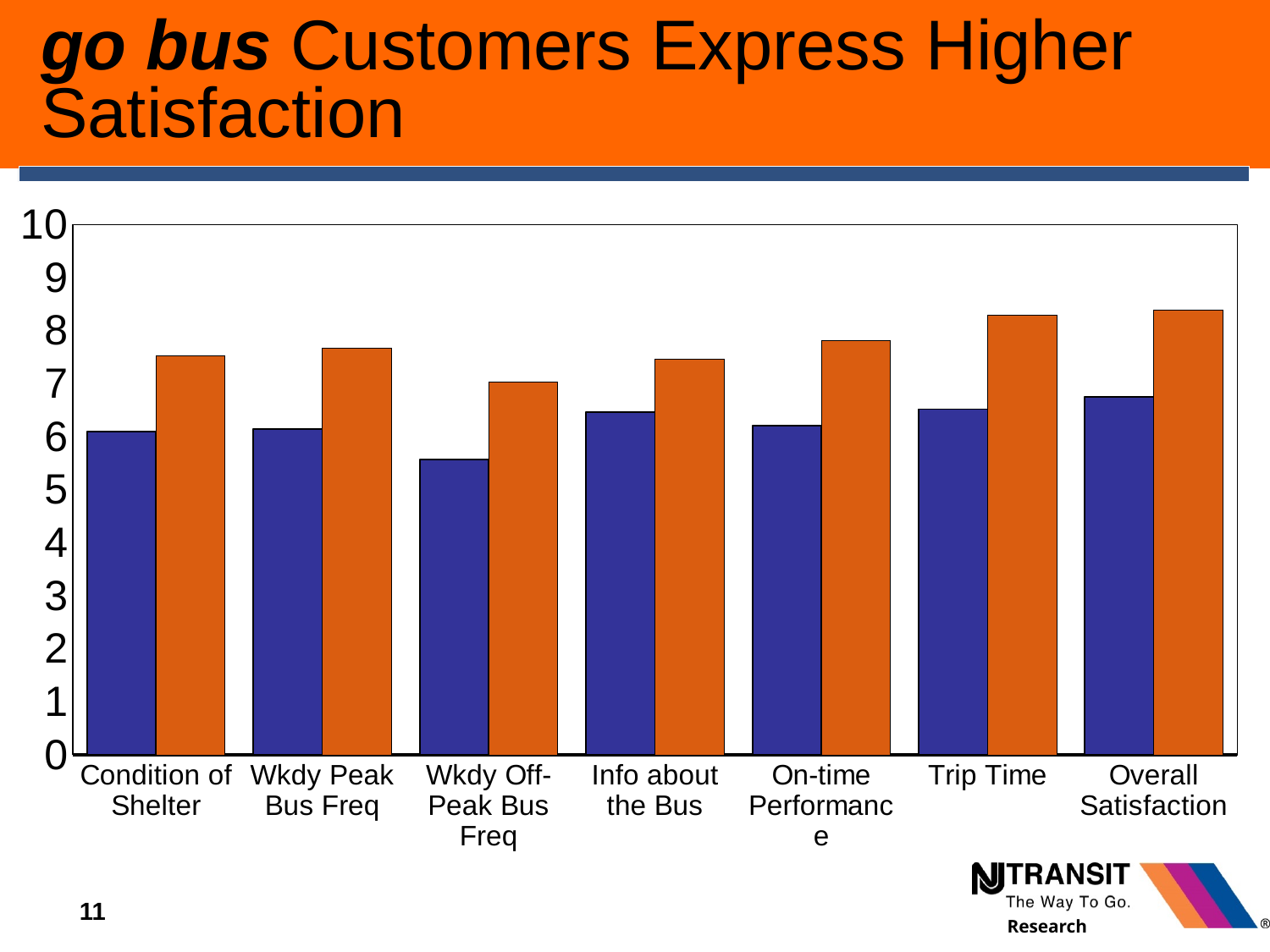
What kind of chart is shown on the slide? bar chart Which is larger, the blue bar for Trip Time or the blue bar for Wkdy Off-Peak Bus Freq? Trip Time Which category has the lowest blue bar? Wkdy Off-Peak Bus Freq Is the orange bar for On-time Performance greater or less than 8? less For Overall Satisfaction, which bar is larger, the blue one or the orange one? orange Which category has the lowest orange bar? Wkdy Off-Peak Bus Freq How many categories are shown along the x axis of the chart? 7 Is the blue bar for Wkdy Off-Peak Bus Freq greater or less than 6? less Is the orange bar for Trip Time greater or less than 8? greater Which category has the highest blue bar? Overall Satisfaction How many bar colours (series) are plotted for each category? 2